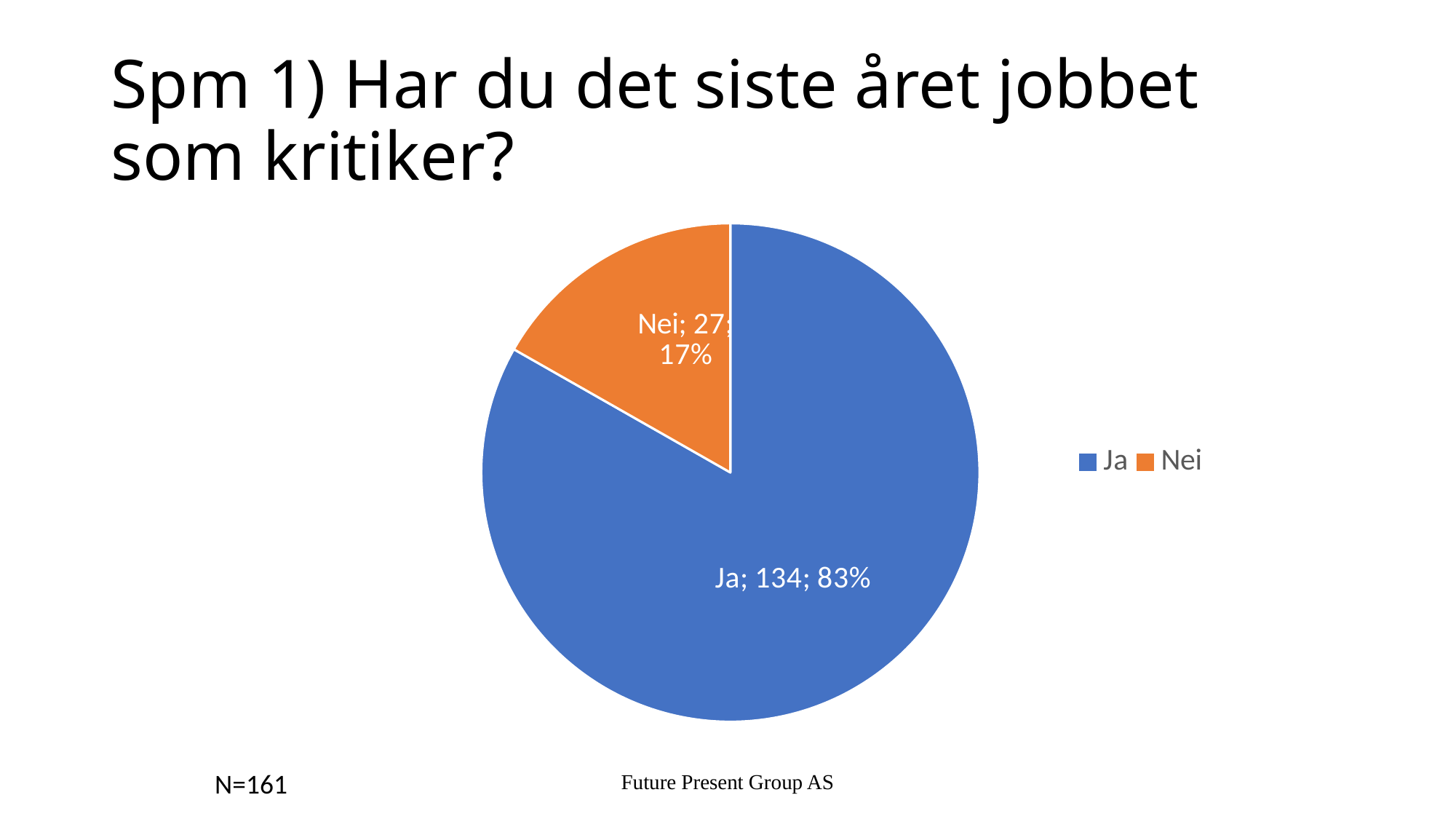
What colour is the "Nei" slice? orange How many respondents answered "Nei"? 27 Which category has the smallest slice of the pie? Nei What kind of chart is shown on the slide? pie chart How many entries does the legend list? 2 What is the difference between the number of "Ja" and "Nei" responses? 107 Which category has the largest slice of the pie? Ja What percentage of the pie does the "Ja" slice represent? 83% How many respondents answered "Ja"? 134 What percentage of the pie does the "Nei" slice represent? 17% Which is larger, the "Ja" slice or the "Nei" slice? Ja How many categories does the pie chart have? 2